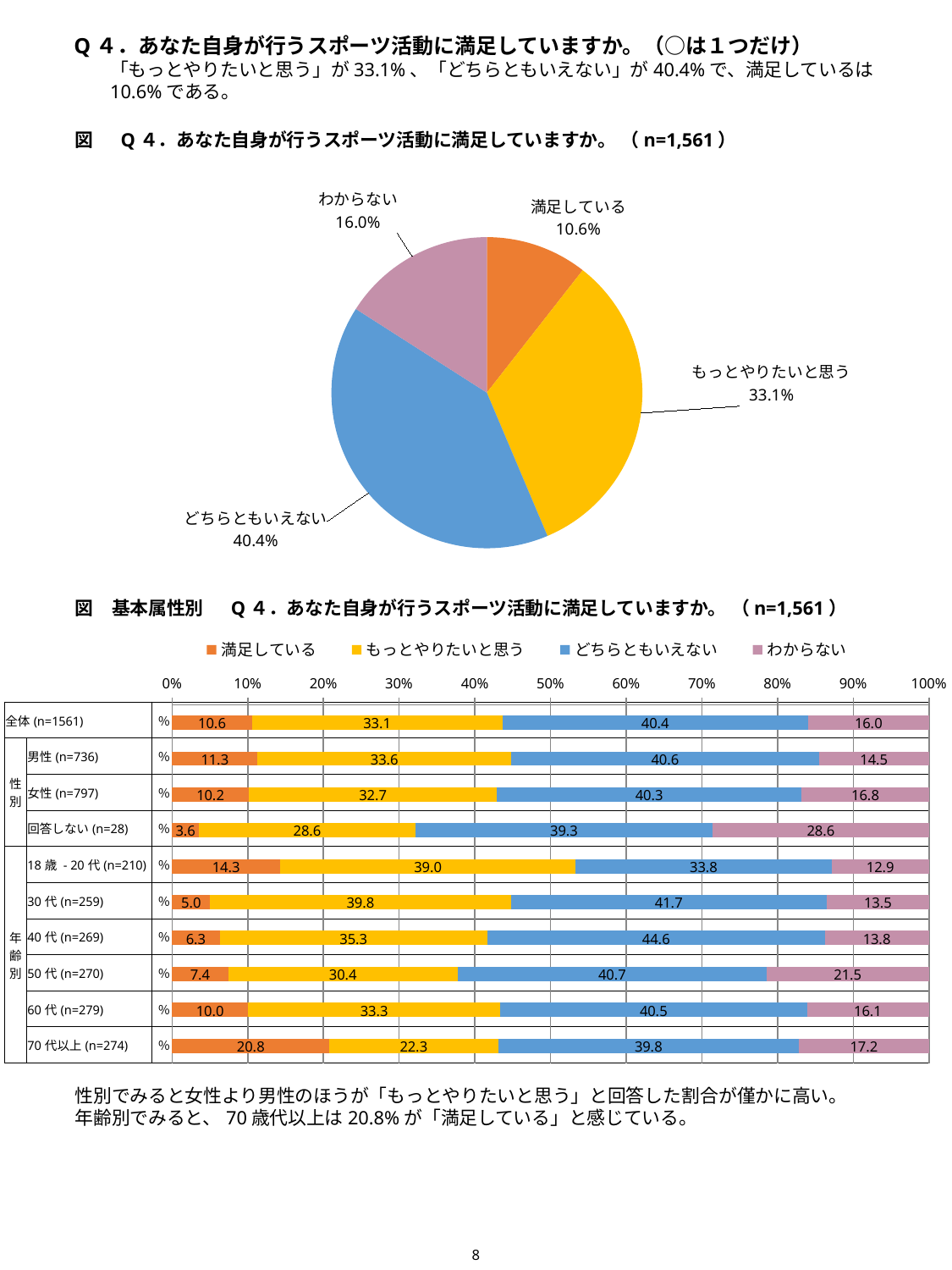
How many series does the legend of the bottom bar chart list? 4 In the top pie chart, which category has the smallest share? 満足している How many slices does the top pie chart have? 4 In the bottom bar chart, what is the value of 満足している for 70代以上 (n=274)? 20.8 In the bottom bar chart, which has the larger value for どちらともいえない, 30代 (n=259) or 40代 (n=269)? 40代 (n=269) In the bottom bar chart, what is the difference between 男性 and 女性 for もっとやりたいと思う? 0.9 What kind of chart is the top chart (図 Q4. あなた自身が行うスポーツ活動に満足していますか)? pie chart In the top pie chart, what is the value for どちらともいえない? 40.4% How many category rows are plotted in the bottom bar chart? 10 What kind of chart is the bottom chart (図 基本属性別 Q4)? stacked bar chart In the top pie chart, which category has the largest share? どちらともいえない In the bottom bar chart, which age group has the highest value for 満足している? 70代以上 (n=274)